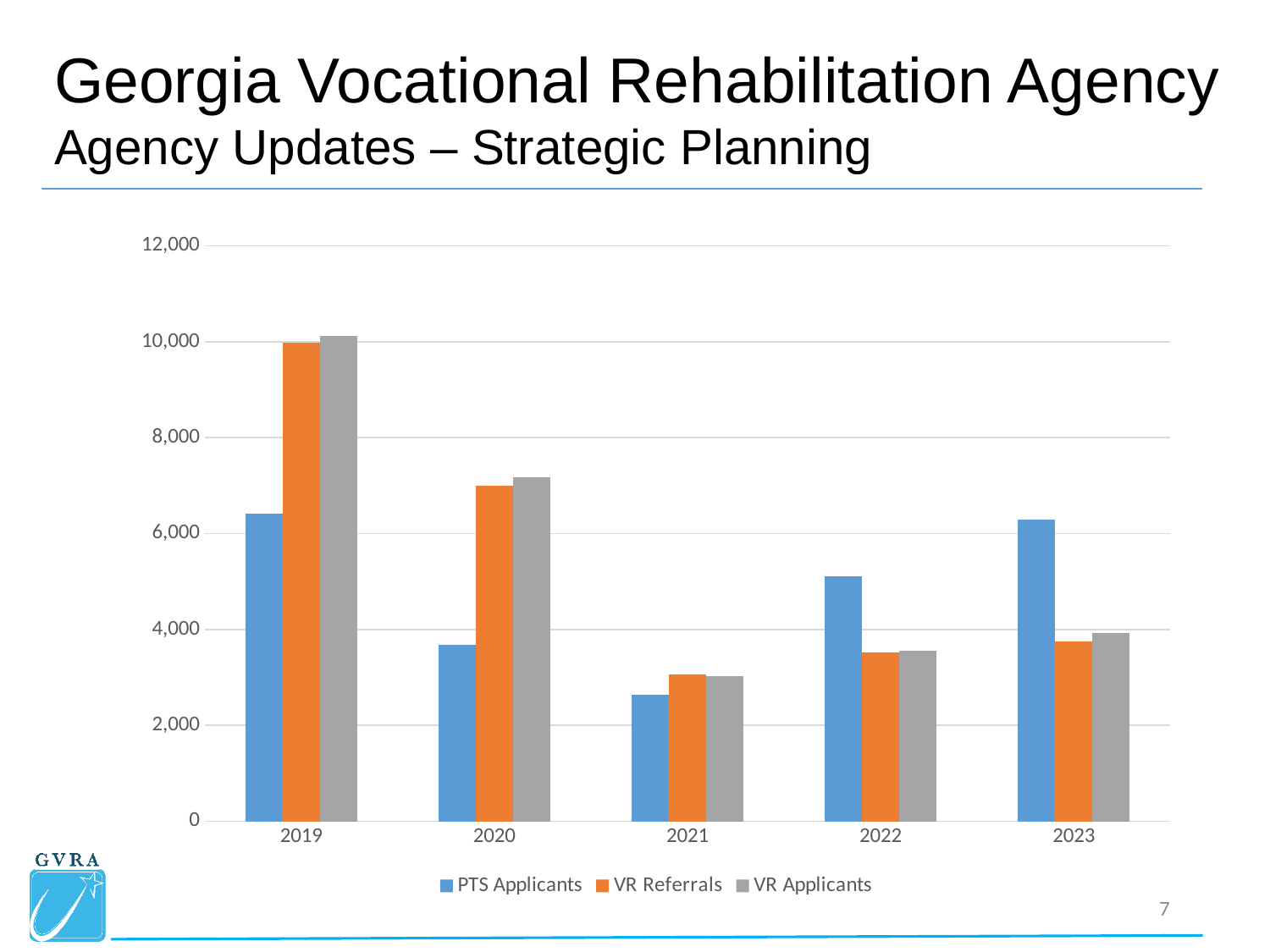
What kind of chart is shown on the slide? Bar chart How many years are shown on the x axis? 5 Which year has the highest value for VR Referrals? 2019 In 2022, which is larger: PTS Applicants or VR Referrals? PTS Applicants How many series does the legend list? 3 Is the value for PTS Applicants in 2019 greater or less than 6,000? greater Is the value for VR Referrals in 2023 greater or less than 4,000? less Which year has the lowest value for PTS Applicants? 2021 In 2019, which is larger: PTS Applicants or VR Referrals? VR Referrals Is the value for VR Referrals in 2020 greater or less than 6,000? greater Do the VR Referrals values rise or fall from 2019 to 2021? fall